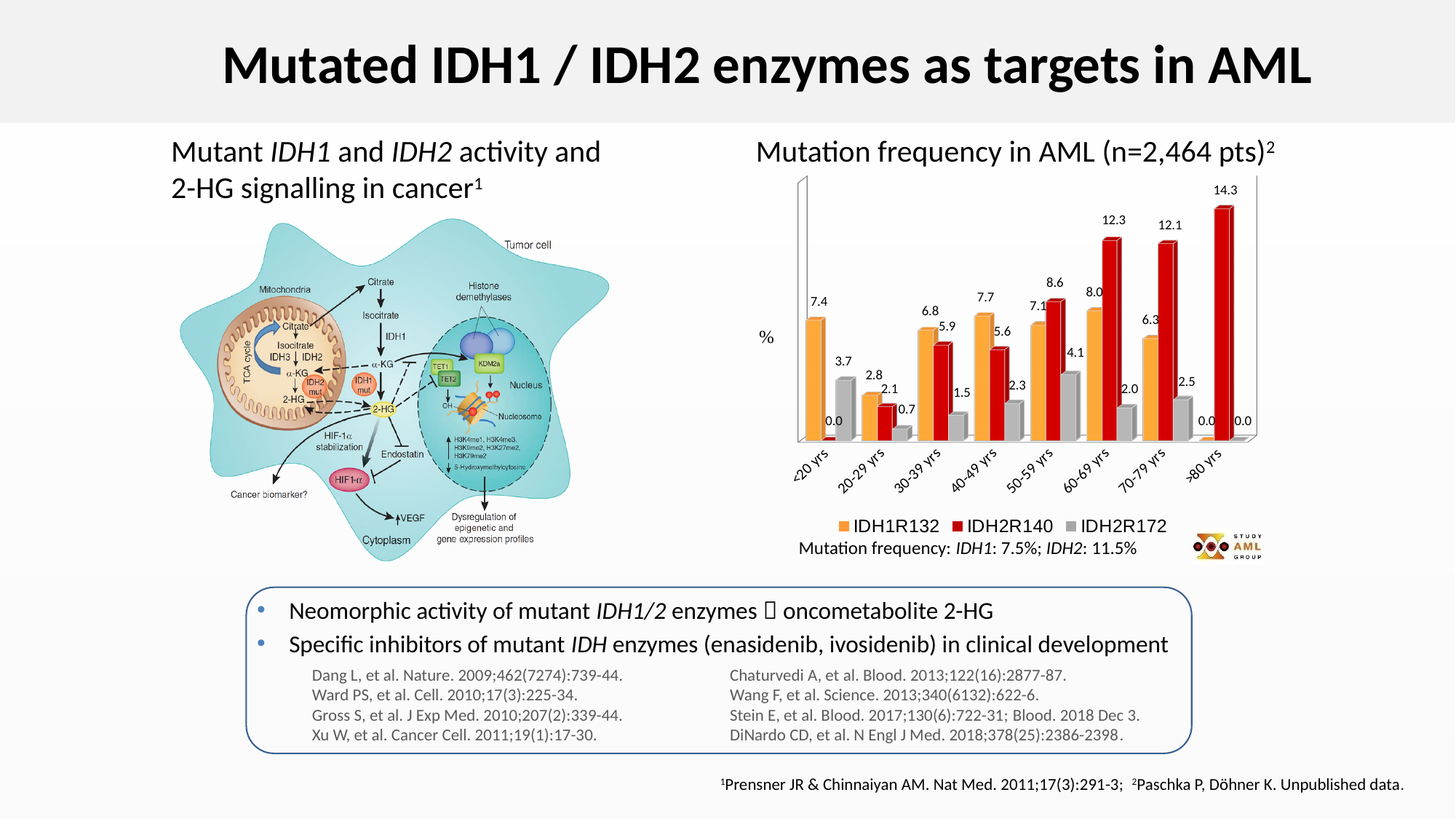
Which age group has the lowest IDH1R132 value? >80 yrs What kind of chart is used to show mutation frequency in AML? Bar chart What is the title of the chart? Mutation frequency in AML (n=2,464 pts) Which age group has the highest IDH2R140 value? >80 yrs What is the difference between the IDH2R140 and IDH1R132 values for the 60-69 yrs age group? 4.3 Does the IDH2R140 value rise or fall from the 20-29 yrs group to the >80 yrs group? Rise What is the IDH2R140 value for the >80 yrs age group? 14.3 What is the IDH1R132 value for the <20 yrs age group? 7.4 For the 40-49 yrs age group, which is larger: IDH1R132 or IDH2R140? IDH1R132 How many series does the chart legend list? 3 What is the IDH2R172 value for the 50-59 yrs age group? 4.1 How many age groups are shown on the x axis of the chart? 8